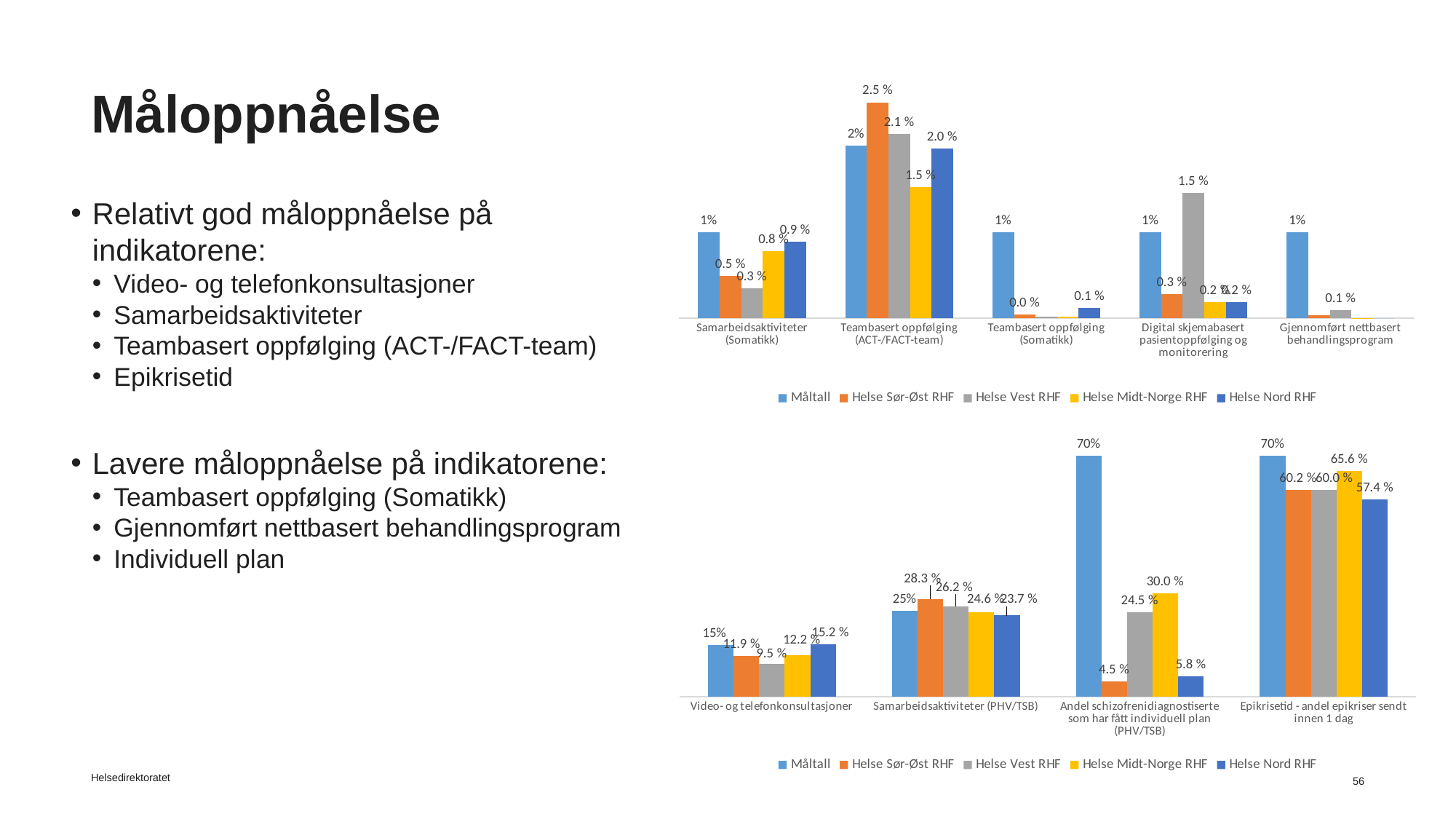
In the bottom chart, which is larger for Samarbeidsaktiviteter (PHV/TSB): Helse Sør-Øst RHF or Helse Nord RHF? Helse Sør-Øst RHF In the bottom chart, what is the value for Helse Midt-Norge RHF for Epikrisetid - andel epikriser sendt innen 1 dag? 65.6 % In the top chart, how many series does the legend list? 5 In the top chart, how many categories are shown on the x axis? 5 In the bottom chart, what is the difference between the Måltall and the Helse Nord RHF value for Epikrisetid - andel epikriser sendt innen 1 dag? 12.6 % In the top chart, what is the value for Helse Sør-Øst RHF for Teambasert oppfølging (ACT-/FACT-team)? 2.5 % In the top chart, which series has the highest value for Teambasert oppfølging (ACT-/FACT-team)? Helse Sør-Øst RHF In the bottom chart, which colour represents Måltall in the legend? Light blue In the bottom chart, what is the value for Helse Sør-Øst RHF for Andel schizofrenidiagnostiserte som har fått individuell plan (PHV/TSB)? 4.5 % What kind of chart is the bottom chart? Bar chart In the bottom chart, which series has the lowest value for Video- og telefonkonsultasjoner? Helse Vest RHF In the top chart, what is the value for Helse Vest RHF for Digital skjemabasert pasientoppfølging og monitorering? 1.5 %